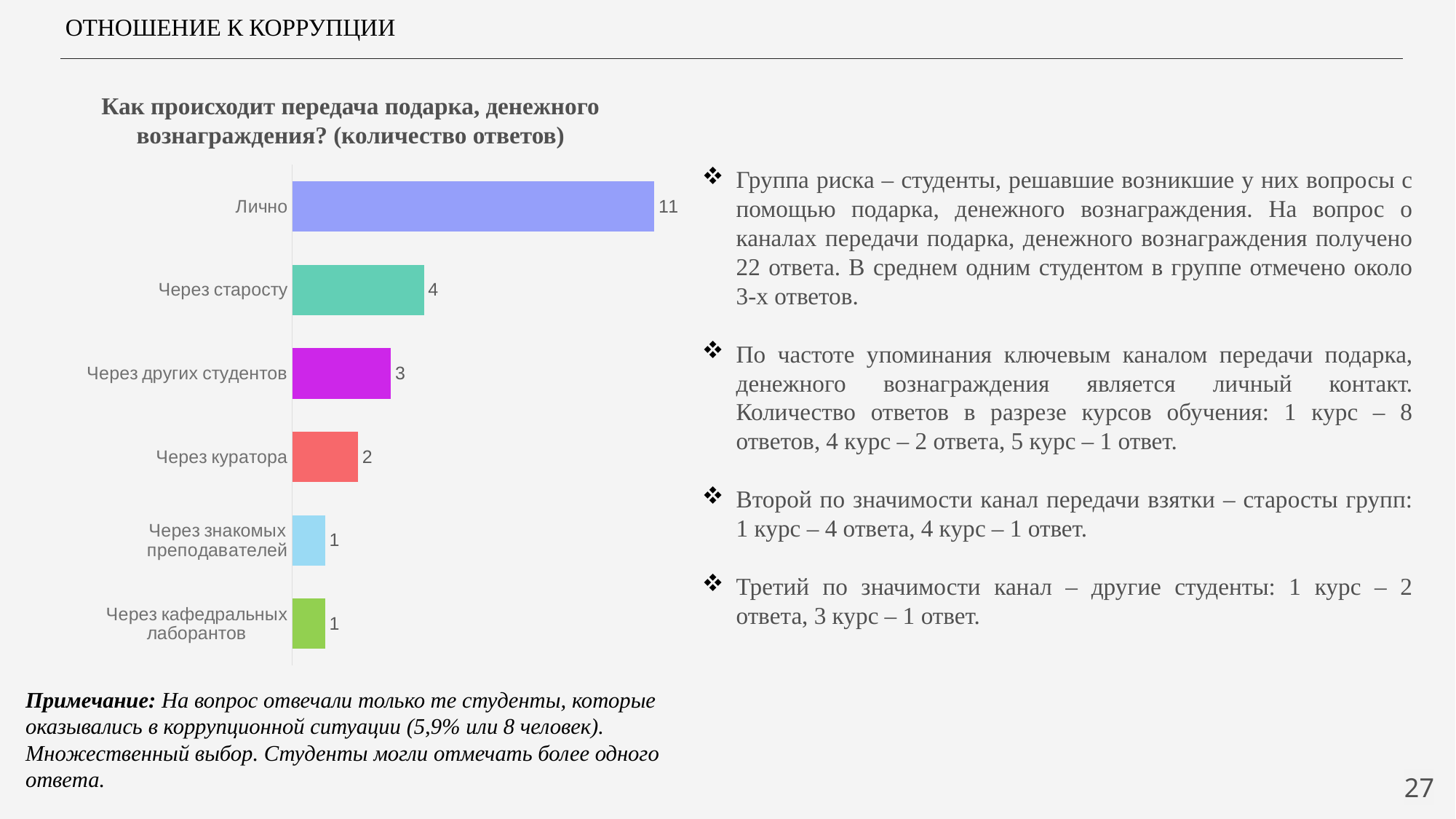
What is the difference between the values for "Через старосту" and "Через знакомых преподавателей"? 3 How many answers are shown for "Лично"? 11 Which is larger: the value for "Через других студентов" or "Через куратора"? Через других студентов What is the value for "Через куратора"? 2 What colour is the bar for "Через куратора"? red What is the title of the chart? Как происходит передача подарка, денежного вознаграждения? (количество ответов) How many categories are shown in the chart? 6 Which category has the highest value? Лично What is the difference between the values for "Лично" and "Через старосту"? 7 What is the value for "Через других студентов"? 3 What type of chart is shown on the slide? bar chart What is the value for "Через старосту"? 4